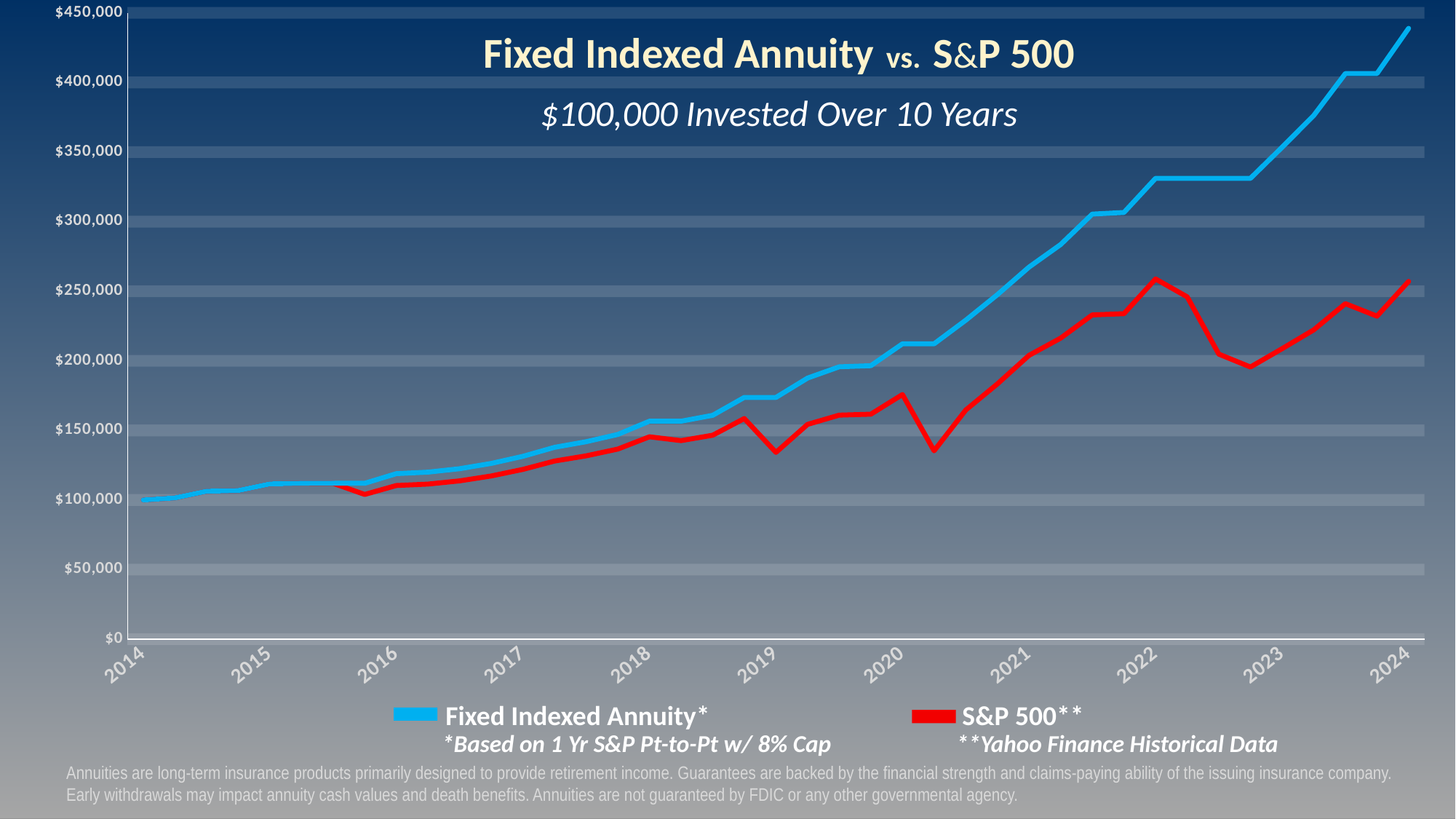
What is the title of the chart? Fixed Indexed Annuity vs. S&P 500 What kind of chart is shown on the slide? Line chart What colour is the line for the S&P 500 series? Red Which series reaches the highest value on the chart? Fixed Indexed Annuity At 2024, which series has the higher value, Fixed Indexed Annuity or S&P 500? Fixed Indexed Annuity Is the value of the S&P 500 line at 2024 greater or less than $200,000? greater Is the value of the Fixed Indexed Annuity line at 2024 greater or less than $400,000? greater How many year labels are shown along the x axis? 11 Does the Fixed Indexed Annuity line generally rise or fall from 2014 to 2024? Rise Is the value of the S&P 500 line at 2020 greater or less than $200,000? less How many series does the legend list? 2